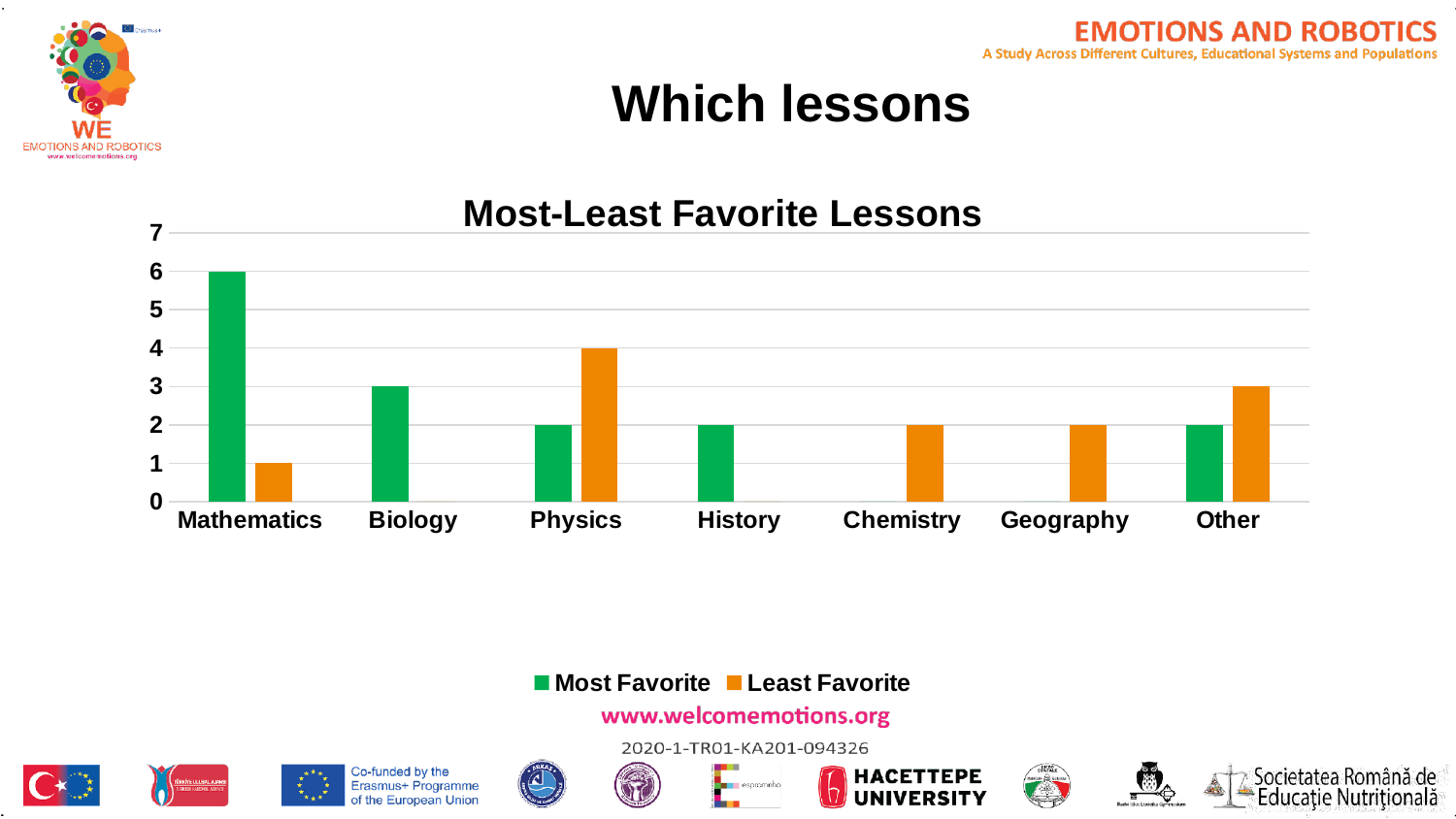
What type of chart is shown on the slide? bar chart How many lesson categories are shown on the x axis? 7 What is the difference between the Most Favorite and Least Favorite values for Mathematics? 5 How many series does the legend list? 2 What is the Least Favorite value for Physics? 4 Which lesson has the highest Most Favorite value? Mathematics What is the Most Favorite value for Mathematics? 6 What is the title of the chart? Most-Least Favorite Lessons Which is larger for Physics, the Most Favorite value or the Least Favorite value? Least Favorite What is the Least Favorite value for Other? 3 Which lesson has the highest Least Favorite value? Physics Is the Most Favorite value for Biology greater or less than 2? greater